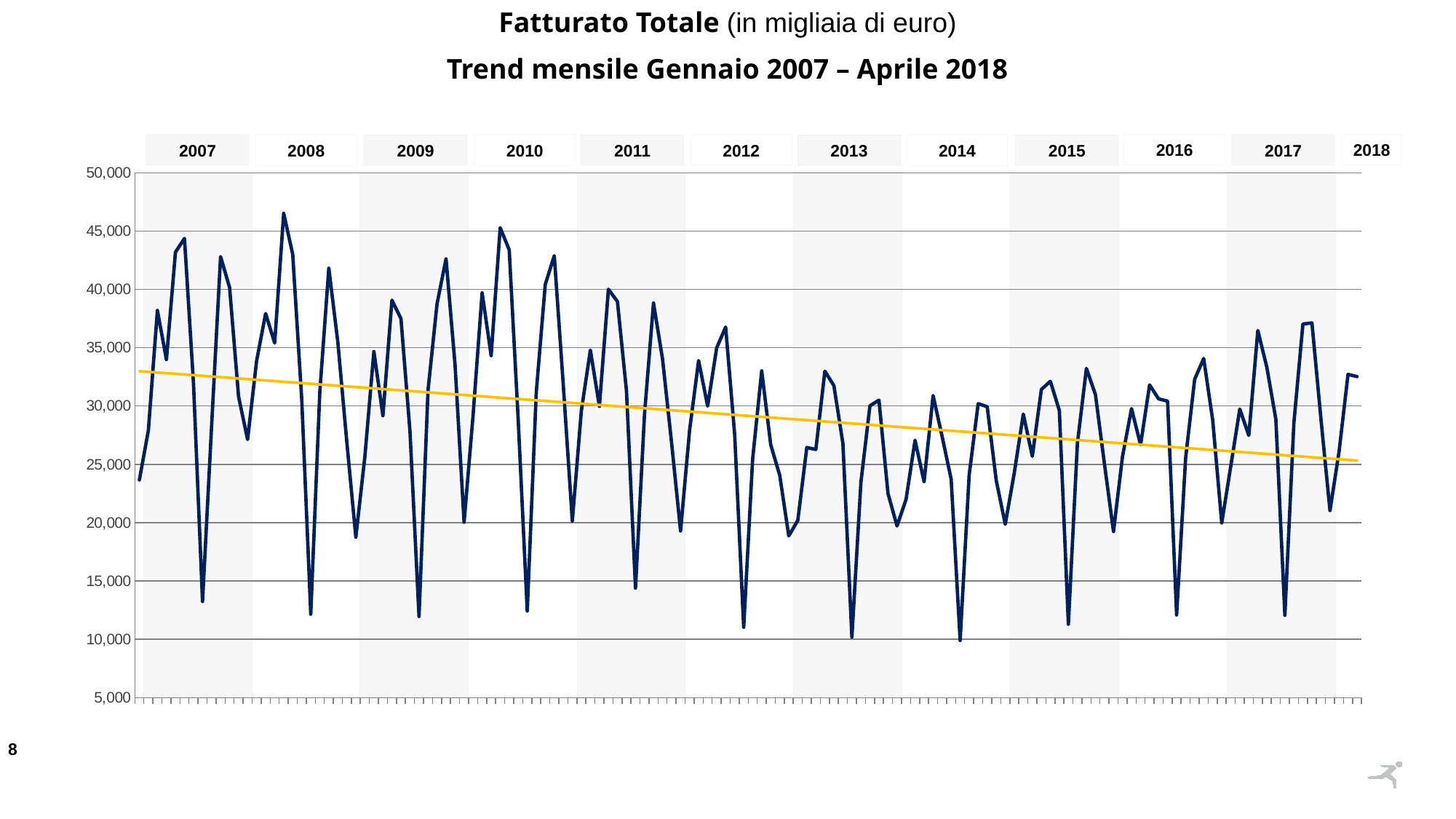
What is the highest value shown on the vertical axis? 50,000 Is the last plotted value in 2018 greater or less than 30,000? greater How many year labels are shown along the top of the chart? 12 Which year contains the highest peak of the whole series? 2008 Is the highest peak in 2017 greater or less than 40,000? less What period does the chart title say the monthly trend covers? Gennaio 2007 – Aprile 2018 Does the yellow trend line rise or fall from 2007 to 2018? fall Is the highest peak in 2015 greater or less than 35,000? less What kind of chart is shown on the slide? line chart